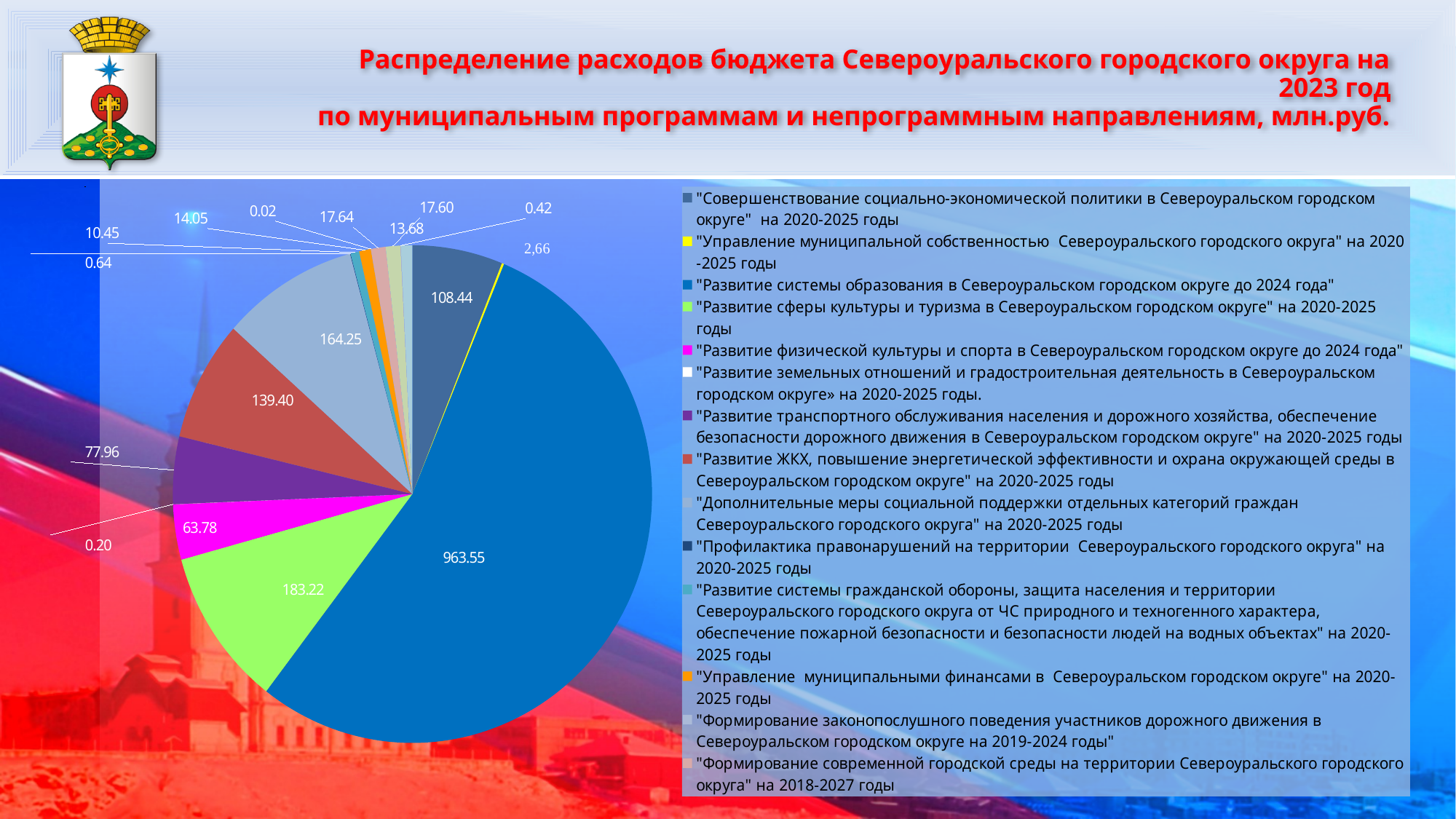
In what units are the values on the chart expressed, according to the slide title? млн.руб. What is the difference between the values for "Развитие сферы культуры и туризма" and "Развитие ЖКХ, повышение энергетической эффективности и охрана окружающей среды"? 43.82 What kind of chart is shown on the slide? pie chart What is the value for "Развитие транспортного обслуживания населения и дорожного хозяйства, обеспечение безопасности дорожного движения"? 77.96 What is the smallest value labelled on the pie chart? 0.02 Which programme has the largest slice of the pie? "Развитие системы образования в Североуральском городском округе до 2024 года" What is the value for "Развитие системы образования в Североуральском городском округе до 2024 года"? 963.55 What is the value for "Дополнительные меры социальной поддержки отдельных категорий граждан Североуральского городского округа"? 164.25 What is the value for "Развитие ЖКХ, повышение энергетической эффективности и охрана окружающей среды в Североуральском городском округе"? 139.40 What is the value for "Развитие физической культуры и спорта в Североуральском городском округе до 2024 года"? 63.78 Which is larger: the value for "Дополнительные меры социальной поддержки отдельных категорий граждан" or the value for "Совершенствование социально-экономической политики"? "Дополнительные меры социальной поддержки отдельных категорий граждан" What is the value for "Развитие сферы культуры и туризма в Североуральском городском округе" на 2020-2025 годы? 183.22